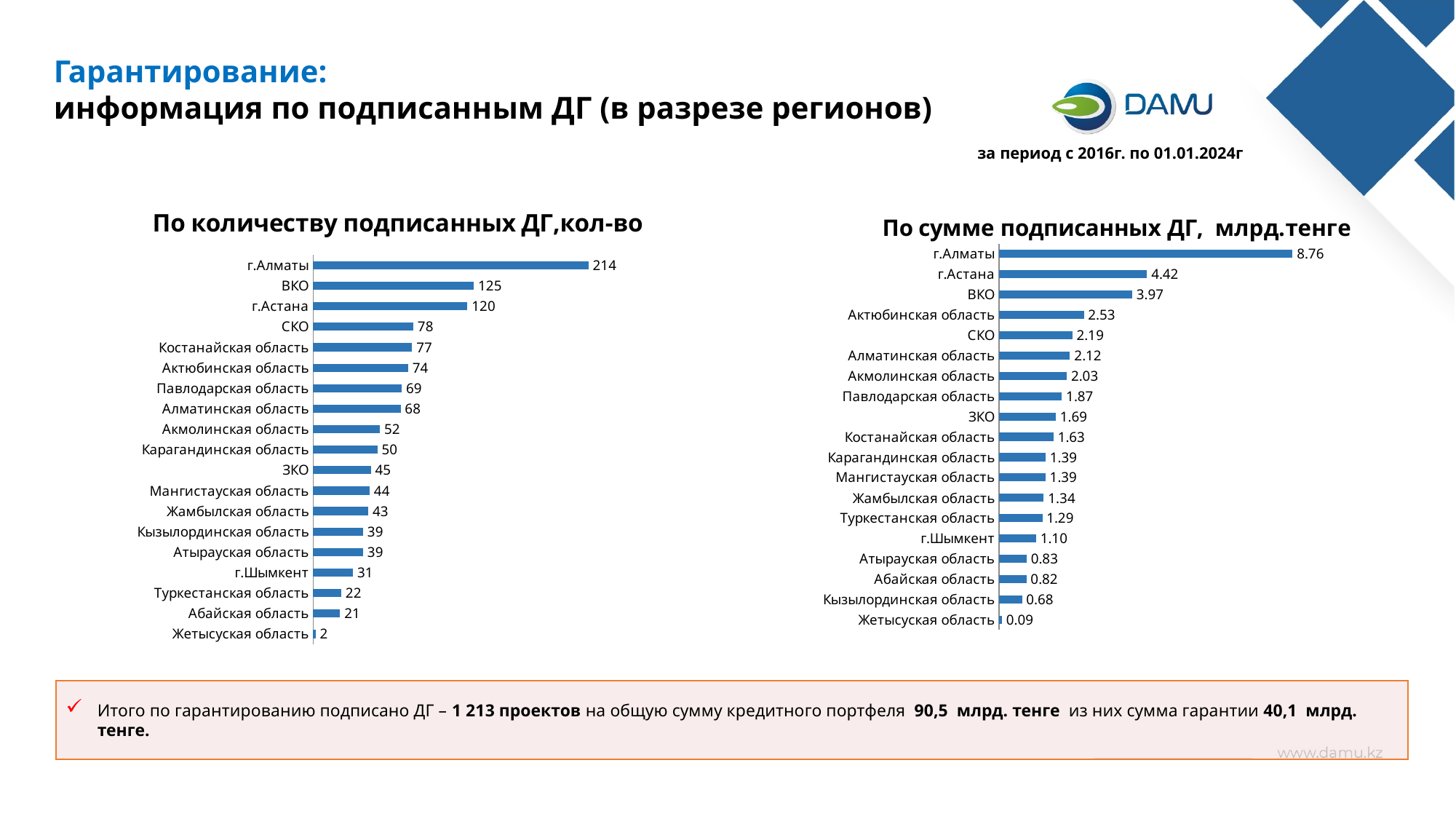
In the chart 'По количеству подписанных ДГ,кол-во', how many categories are shown? 19 In the chart 'По сумме подписанных ДГ, млрд.тенге', what is the value for Туркестанская область? 1.29 In the chart 'По сумме подписанных ДГ, млрд.тенге', which category has the highest value? г.Алматы In the chart 'По сумме подписанных ДГ, млрд.тенге', what is the value for г.Астана? 4.42 In the chart 'По сумме подписанных ДГ, млрд.тенге', what is the difference between г.Алматы and ВКО? 4.79 In the chart 'По количеству подписанных ДГ,кол-во', what is the value for Павлодарская область? 69 In the chart 'По сумме подписанных ДГ, млрд.тенге', which is larger: Актюбинская область or СКО? Актюбинская область What type of chart is 'По сумме подписанных ДГ, млрд.тенге'? Bar chart In the chart 'По количеству подписанных ДГ,кол-во', what is the value for г.Алматы? 214 In the chart 'По количеству подписанных ДГ,кол-во', which category has the lowest value? Жетысуская область In the chart 'По количеству подписанных ДГ,кол-во', what is the difference between ВКО and г.Астана? 5 In the chart 'По количеству подписанных ДГ,кол-во', which is larger: г.Шымкент or Туркестанская область? г.Шымкент